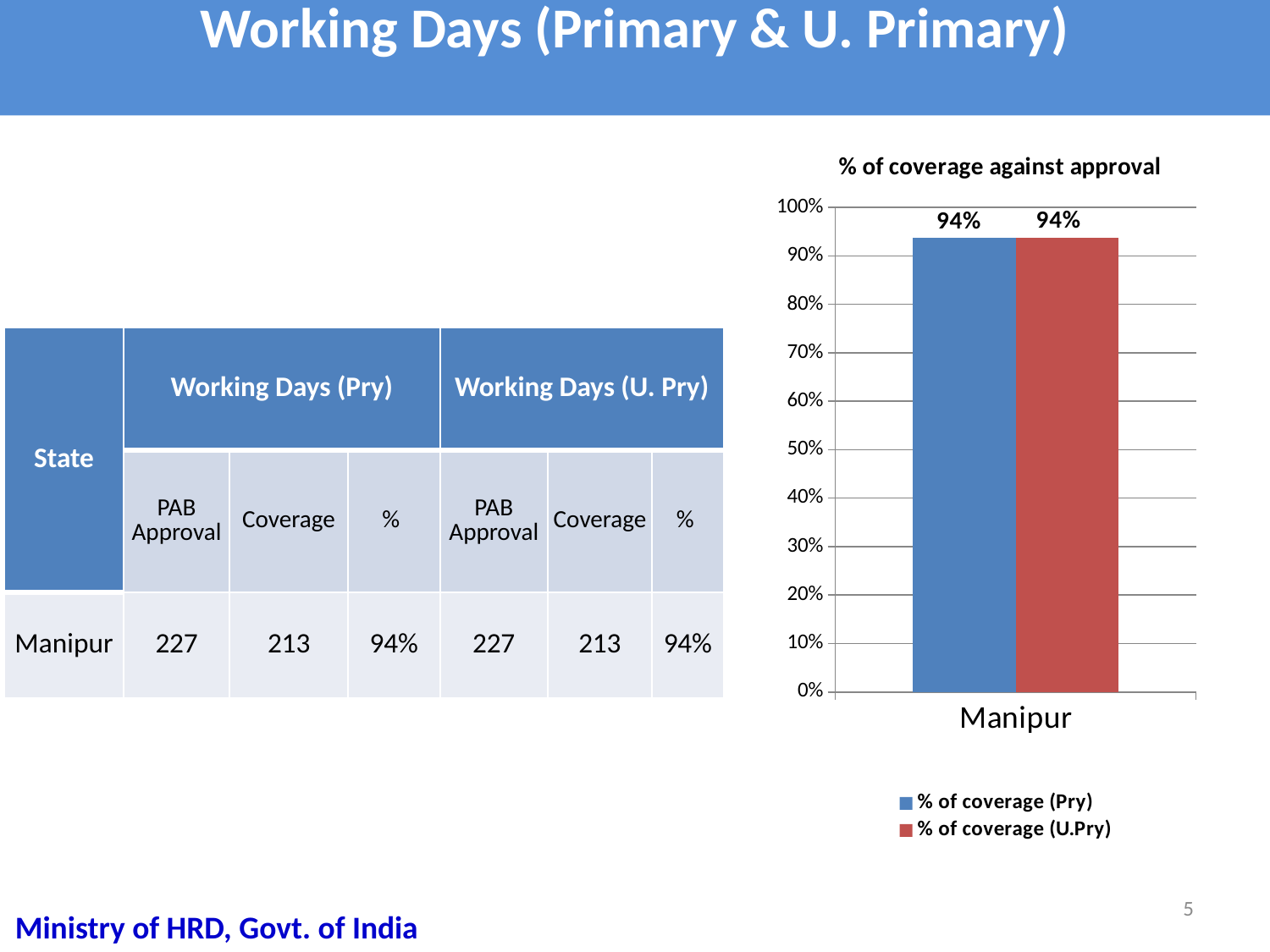
What is the value of % of coverage (U.Pry) for Manipur? 94% How many categories are shown on the x axis of the chart? 1 How many series does the chart's legend list? 2 What is the highest value shown on the chart's y axis? 100% Which series is shown in red in the chart? % of coverage (U.Pry) What is the value of % of coverage (Pry) for Manipur? 94% Is the value of % of coverage (U.Pry) for Manipur greater or less than 100%? less What is the title of the chart? % of coverage against approval What kind of chart is shown on the slide? bar chart What is the difference between % of coverage (Pry) and % of coverage (U.Pry) for Manipur? 0% Is the value of % of coverage (Pry) for Manipur greater or less than 90%? greater